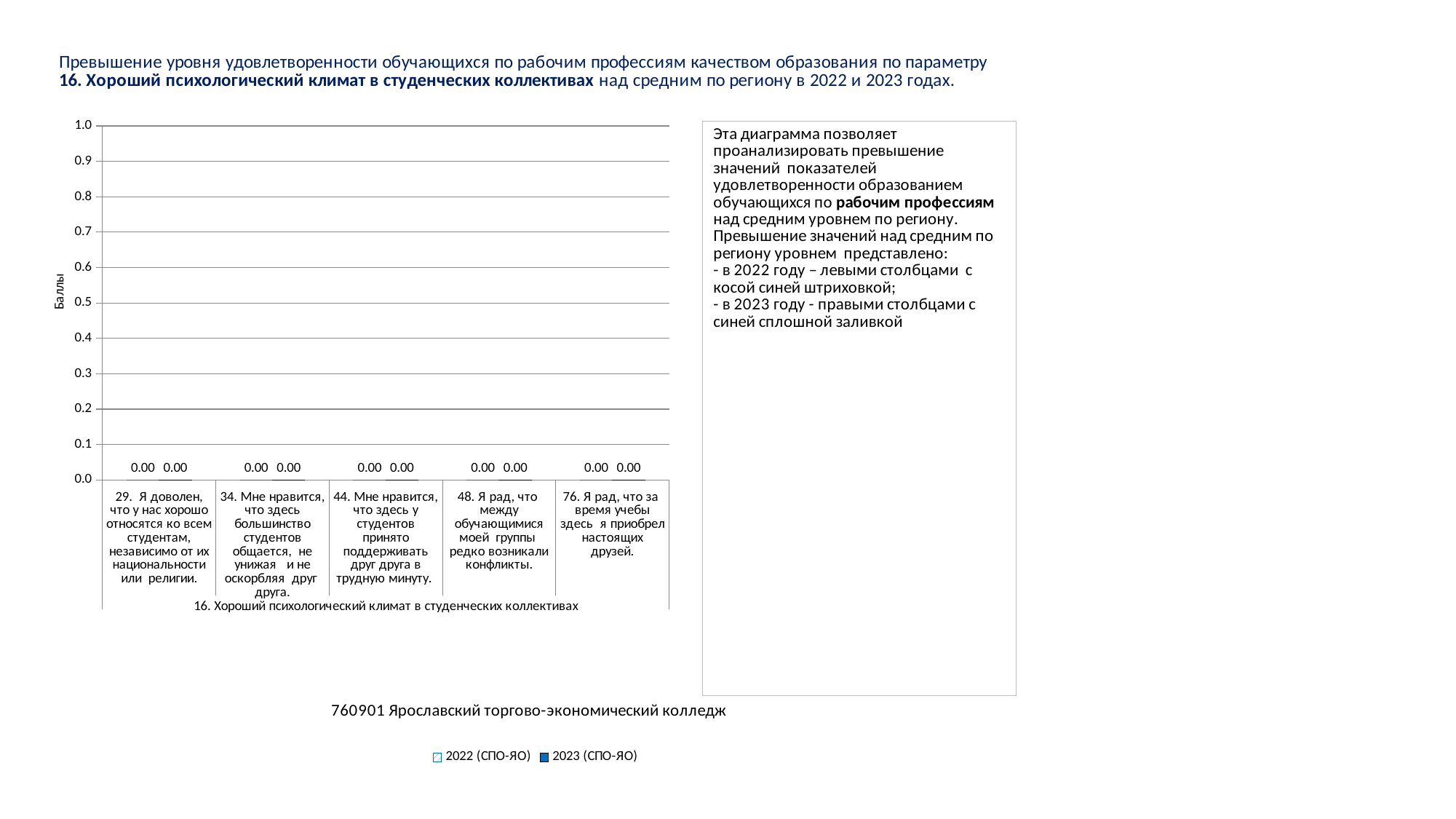
What kind of chart is shown on the slide? bar chart How many categories are shown on the x axis of the chart? 5 Is the value for 2023 (СПО-ЯО) for category 29 greater or less than 0.5? less How many series does the legend list? 2 What is the value for 2023 (СПО-ЯО) for category 76 (Я рад, что за время учебы здесь я приобрел настоящих друзей)? 0.00 What is the highest value shown on the vertical axis? 1.0 What is the label of the vertical axis? Баллы What is the difference between the 2022 (СПО-ЯО) and 2023 (СПО-ЯО) values for category 34? 0.00 What is the value for 2022 (СПО-ЯО) for category 48 (Я рад, что между обучающимися моей группы редко возникали конфликты)? 0.00 What are the two series names listed in the legend? 2022 (СПО-ЯО) and 2023 (СПО-ЯО) What is the value for 2023 (СПО-ЯО) for category 44 (Мне нравится, что здесь у студентов принято поддерживать друг друга в трудную минуту)? 0.00 What is the value for 2022 (СПО-ЯО) for category 29 (Я доволен, что у нас хорошо относятся ко всем студентам...)? 0.00